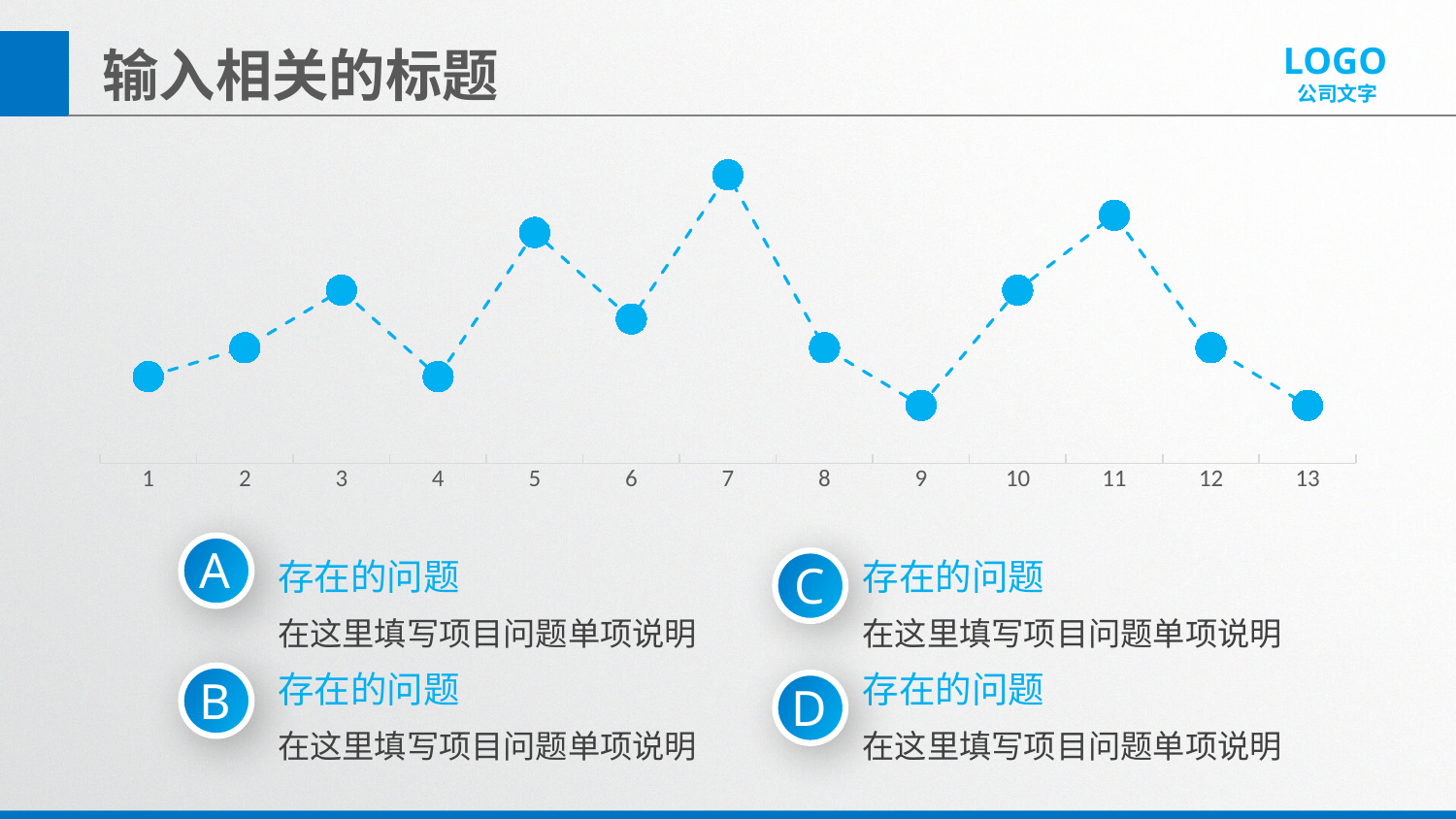
Which is higher, the value at category 5 or the value at category 3? 5 Which is lower, the value at category 9 or the value at category 10? 9 What kind of chart is shown on the slide? line chart Is the line connecting the points drawn solid or dashed? dashed How many data points are plotted on the line chart? 13 Do the values rise or fall from category 1 to category 3? rise What is the title text shown at the top of the slide? 输入相关的标题 Which is higher, the value at category 4 or the value at category 6? 6 Which category on the x axis has the highest value? 7 Do the values rise or fall from category 11 to category 13? fall Do the values rise or fall from category 7 to category 9? fall